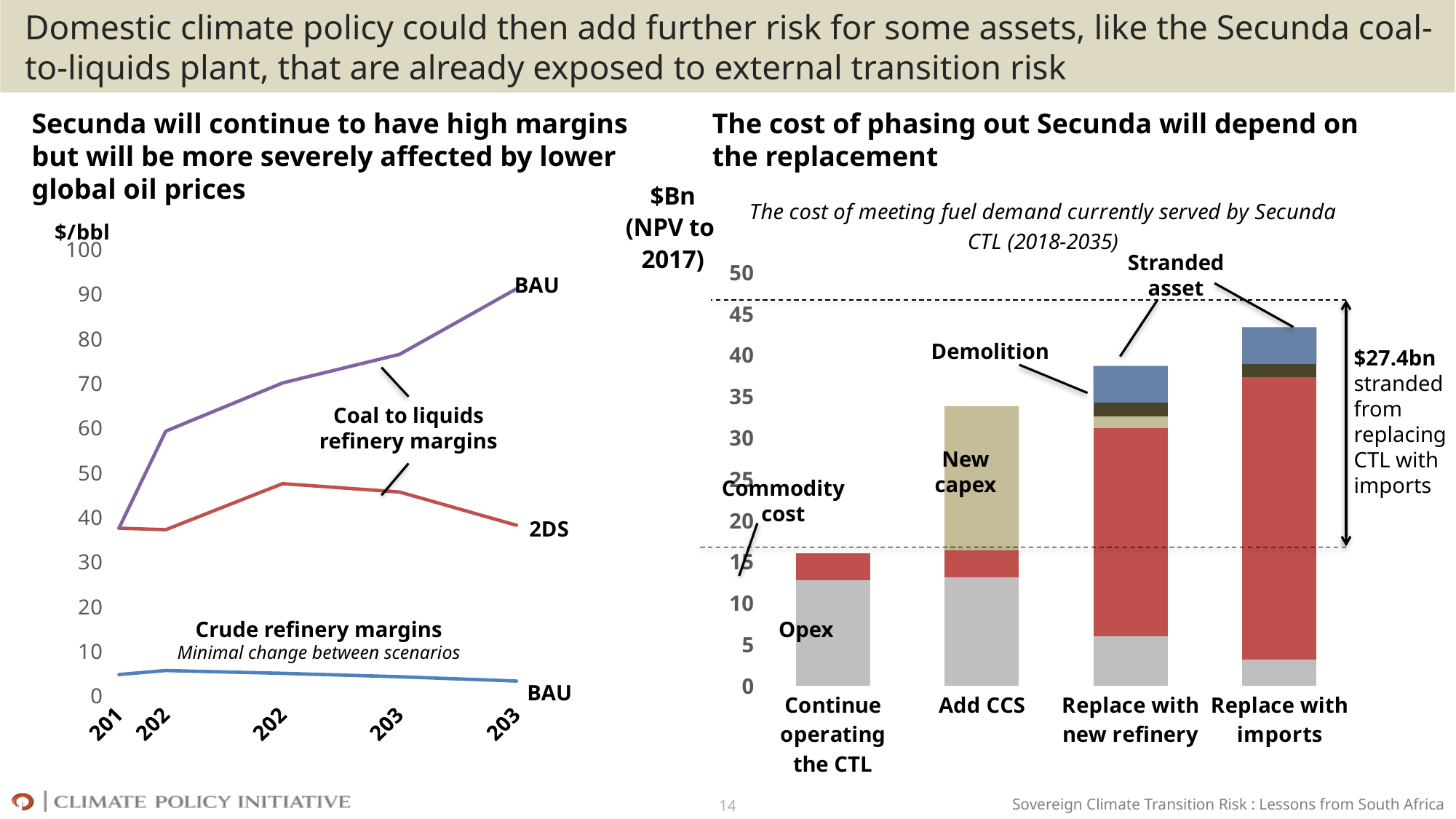
In the right chart, what stranded value is annotated for replacing CTL with imports? $27.4bn In the right chart, which option has the lowest total cost? Continue operating the CTL In the right chart, which has the larger total cost: 'Replace with new refinery' or 'Add CCS'? Replace with new refinery What kind of chart is the left chart, 'Secunda will continue to have high margins...'? line chart In the right chart, is the total cost for 'Continue operating the CTL' greater or less than 20? less In the right chart, which option has the highest total cost? Replace with imports In the left chart, what unit is shown on the y axis? $/bbl In the left chart, does the BAU coal to liquids refinery margin line rise or fall over time? rise In the right chart, how many replacement options (categories) are shown on the x axis? 4 What kind of chart is the right chart, 'The cost of meeting fuel demand currently served by Secunda CTL (2018-2035)'? bar chart In the right chart, is the total cost for 'Replace with imports' greater or less than 40? greater In the right chart, is the total cost for 'Add CCS' greater or less than 30? greater